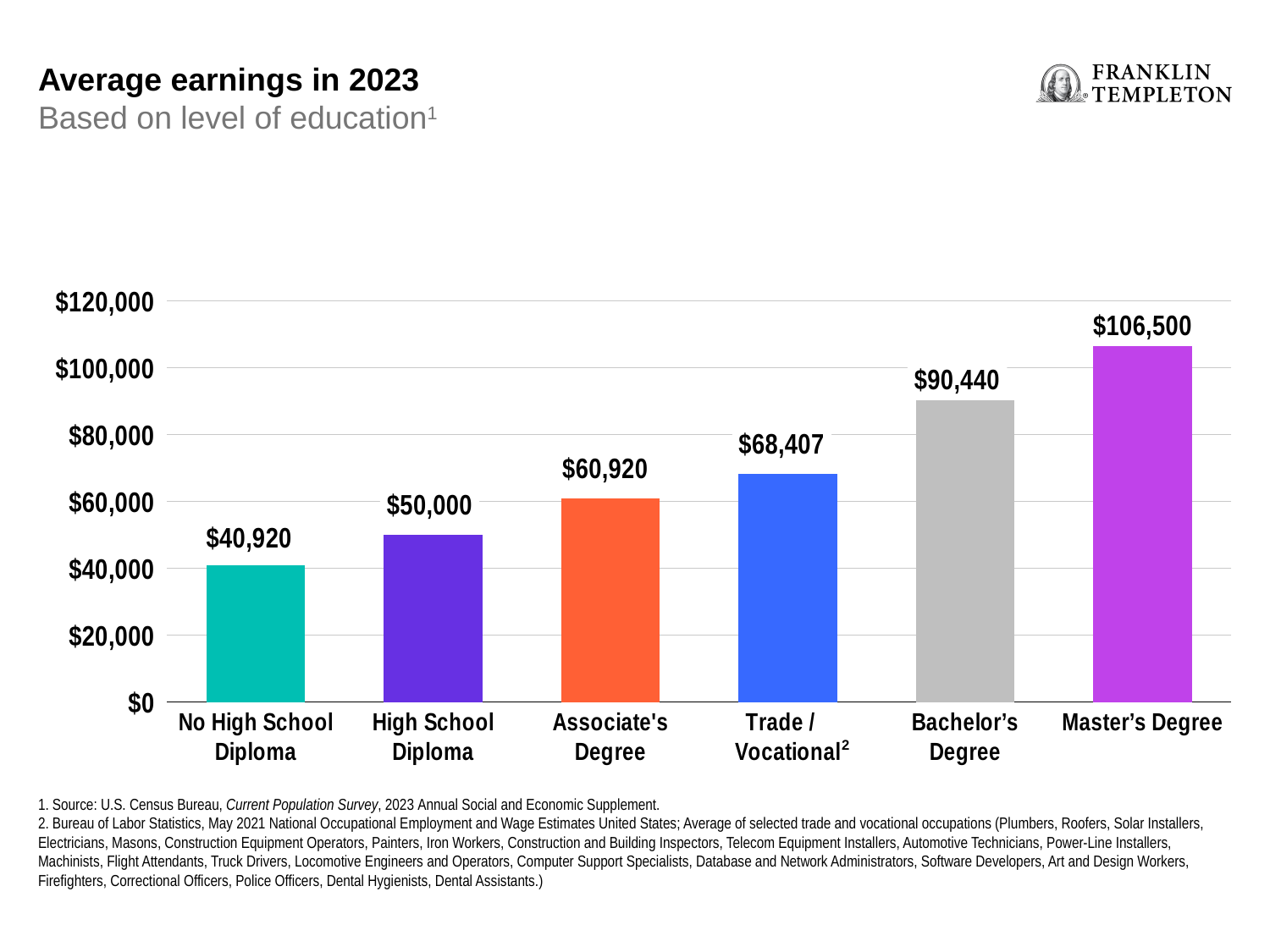
How many education levels are shown in the chart? 6 Is the value for Bachelor's Degree greater or less than $100,000? less What are the average earnings for a Bachelor's Degree? $90,440 What are the average earnings for Trade / Vocational? $68,407 Which education level has the highest average earnings? Master's Degree What is the difference in average earnings between a Master's Degree and a Bachelor's Degree? $16,060 What are the average earnings for No High School Diploma? $40,920 What kind of chart is shown on the slide? Bar chart Which has higher average earnings, Associate's Degree or Trade / Vocational? Trade / Vocational Do the values rise or fall from left to right across the education levels? Rise Which education level has the lowest average earnings? No High School Diploma What is the difference in average earnings between a High School Diploma and No High School Diploma? $9,080